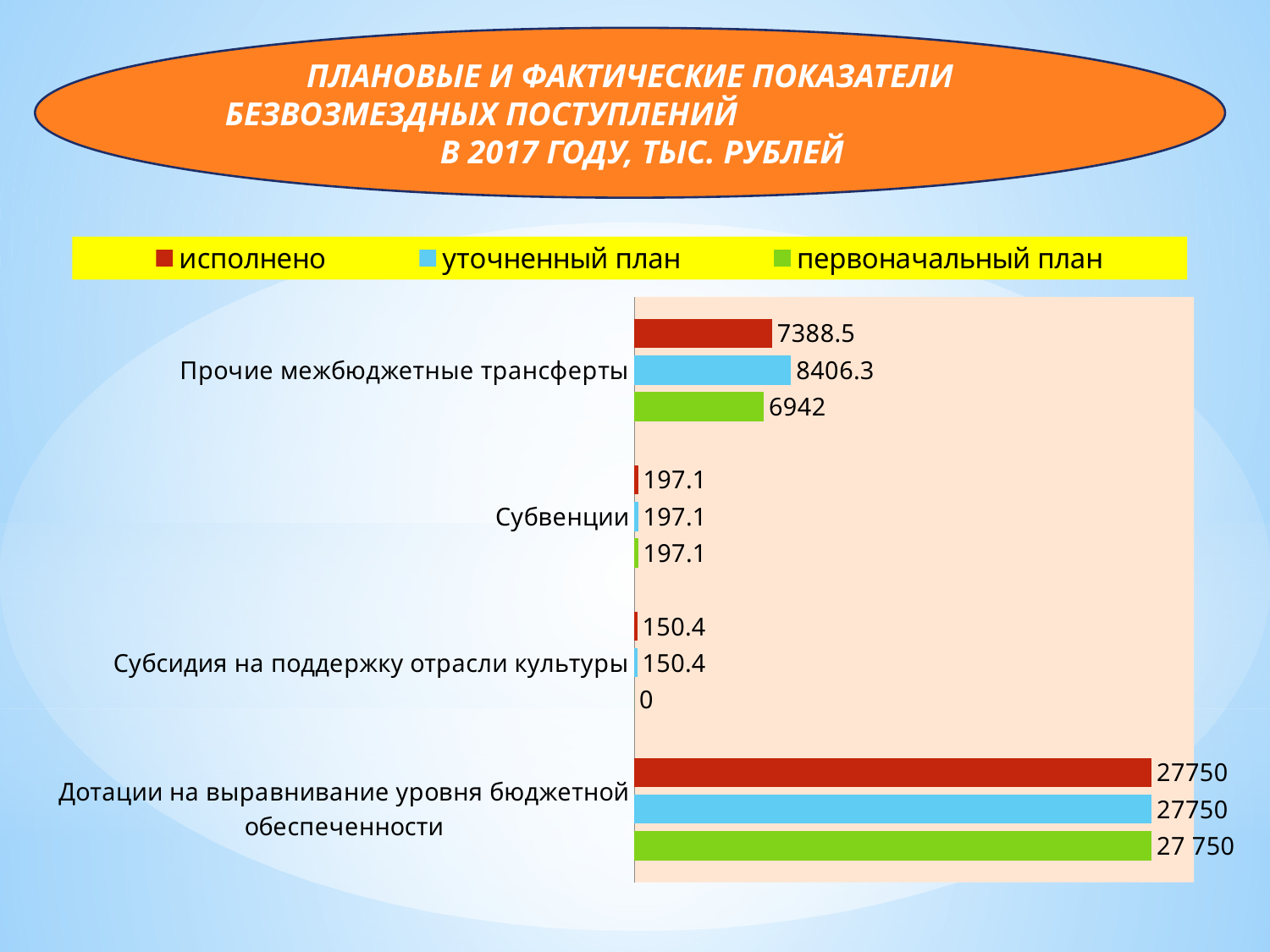
How many series does the legend list? 3 What is the value of "исполнено" for "Субвенции"? 197.1 What is the value of "исполнено" for "Прочие межбюджетные трансферты"? 7388.5 What is the value of "первоначальный план" for "Субсидия на поддержку отрасли культуры"? 0 For "Прочие межбюджетные трансферты", which is larger: "уточненный план" or "первоначальный план"? уточненный план What type of chart is shown on the slide? bar chart How many categories are shown on the chart? 4 Which category has the lowest "уточненный план" value? Субсидия на поддержку отрасли культуры What is the value of "первоначальный план" for "Прочие межбюджетные трансферты"? 6942 What is the value of "уточненный план" for "Прочие межбюджетные трансферты"? 8406.3 What is the difference between "уточненный план" and "исполнено" for "Прочие межбюджетные трансферты"? 1017.8 Which category has the highest "исполнено" value? Дотации на выравнивание уровня бюджетной обеспеченности